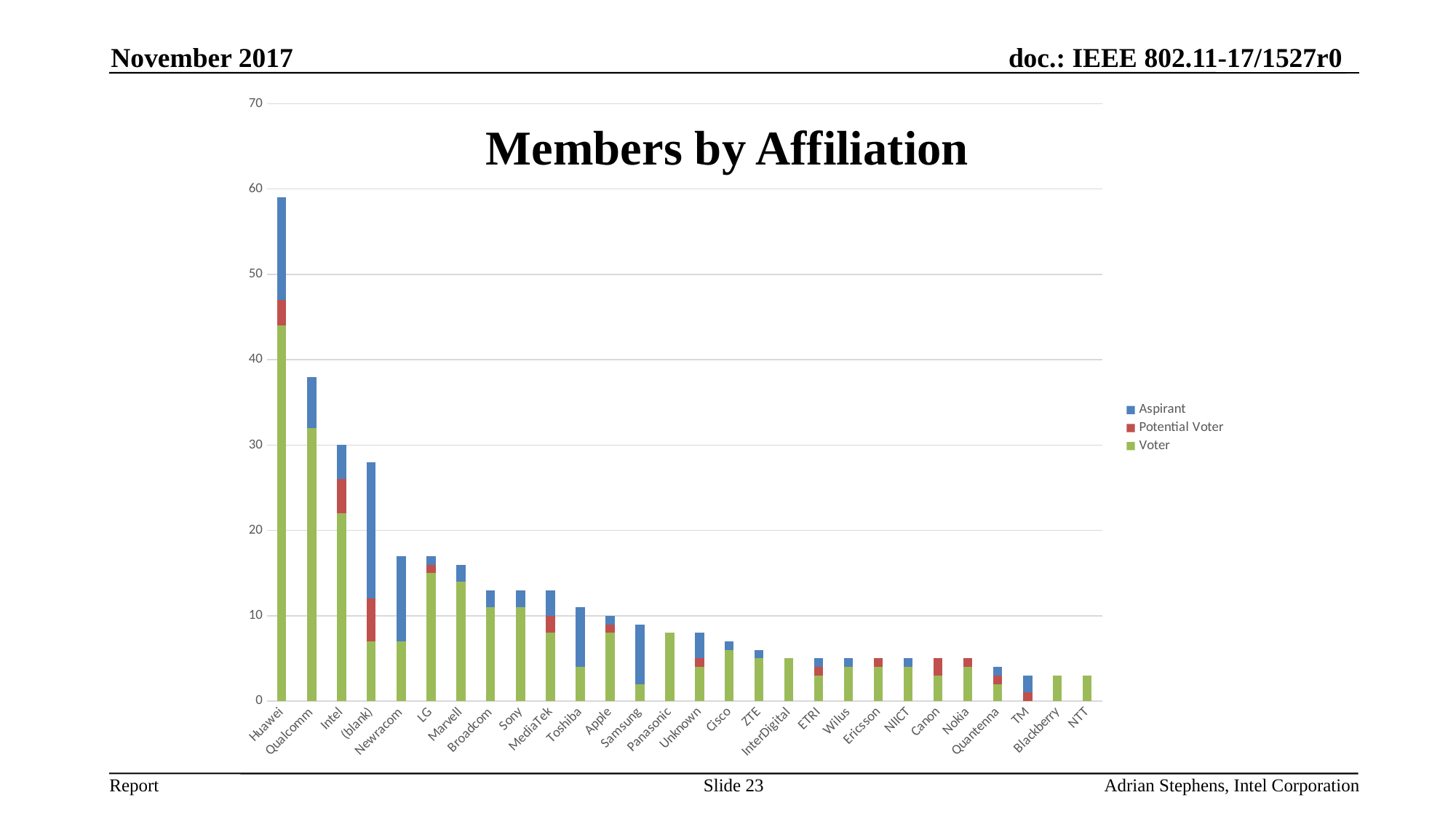
How many series does the legend list? 3 How many affiliations are shown on the x axis? 28 What kind of chart is shown on the slide? stacked bar chart Is the total value for Huawei greater or less than 50? greater Is the total value for Panasonic greater or less than 10? less Which affiliation has the highest total number of members? Huawei Is the total value for Qualcomm greater or less than 40? less What is the title of the chart? Members by Affiliation Do the total bar heights generally rise or fall from left to right along the x axis? fall Which has a larger total, Intel or Newracom? Intel Which series are listed in the legend? Aspirant, Potential Voter, Voter